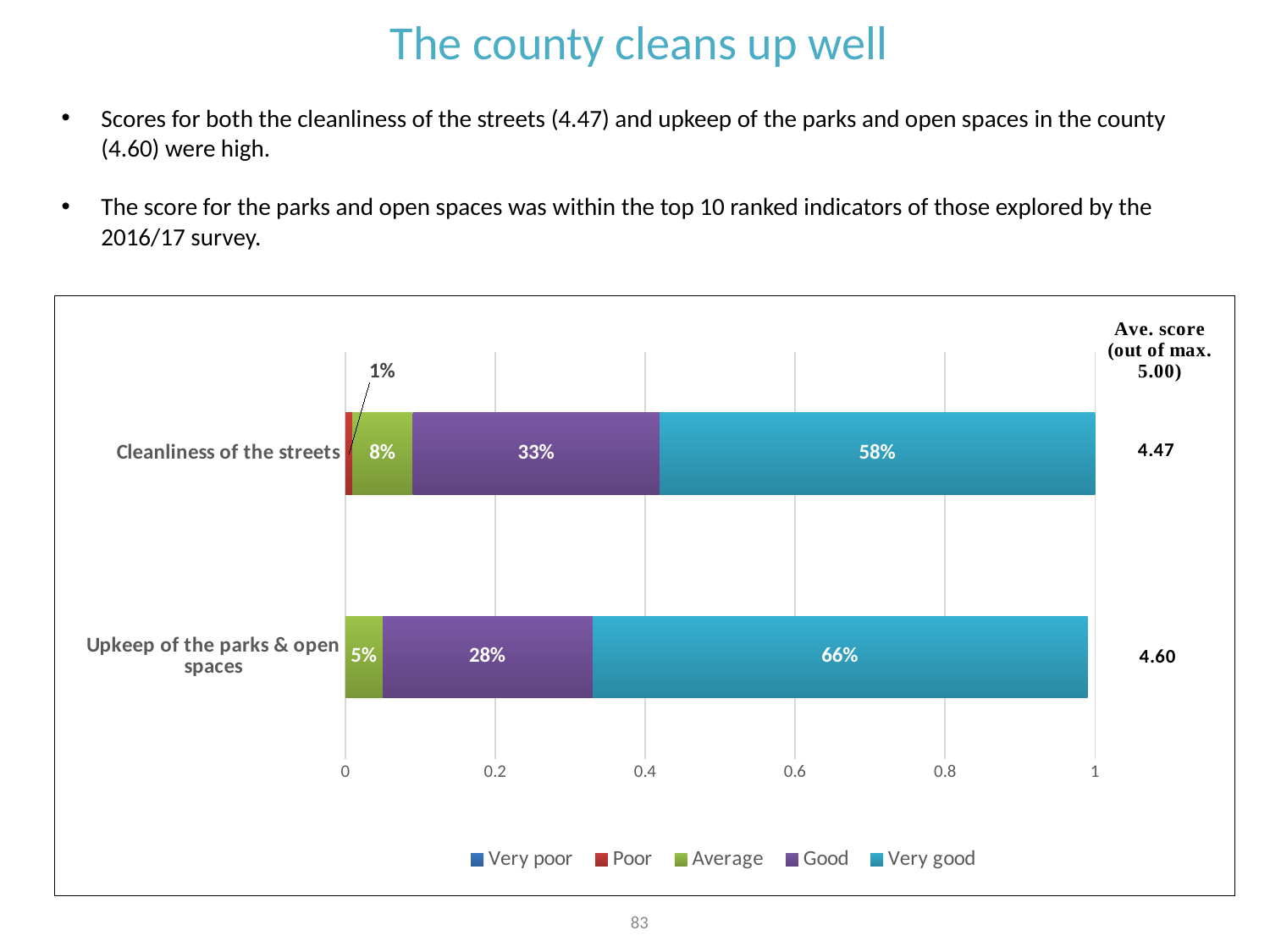
What average score (out of max. 5.00) is shown next to the bar for upkeep of the parks & open spaces? 4.60 What percentage of respondents rated the cleanliness of the streets as 'Poor'? 1% What is the difference between the 'Good' shares for cleanliness of the streets and upkeep of the parks & open spaces? 5% What percentage of respondents rated the cleanliness of the streets as 'Very good'? 58% How many series does the legend list? 5 What percentage of respondents rated the cleanliness of the streets as 'Good'? 33% What type of chart is shown on the slide? Stacked bar chart What percentage of respondents rated the upkeep of the parks & open spaces as 'Very good'? 66% Which category has the larger 'Very good' share, cleanliness of the streets or upkeep of the parks & open spaces? Upkeep of the parks & open spaces How many categories are shown on the chart? 2 What percentage of respondents rated the upkeep of the parks & open spaces as 'Average'? 5% What is the difference between the 'Very good' shares for upkeep of the parks & open spaces and cleanliness of the streets? 8%